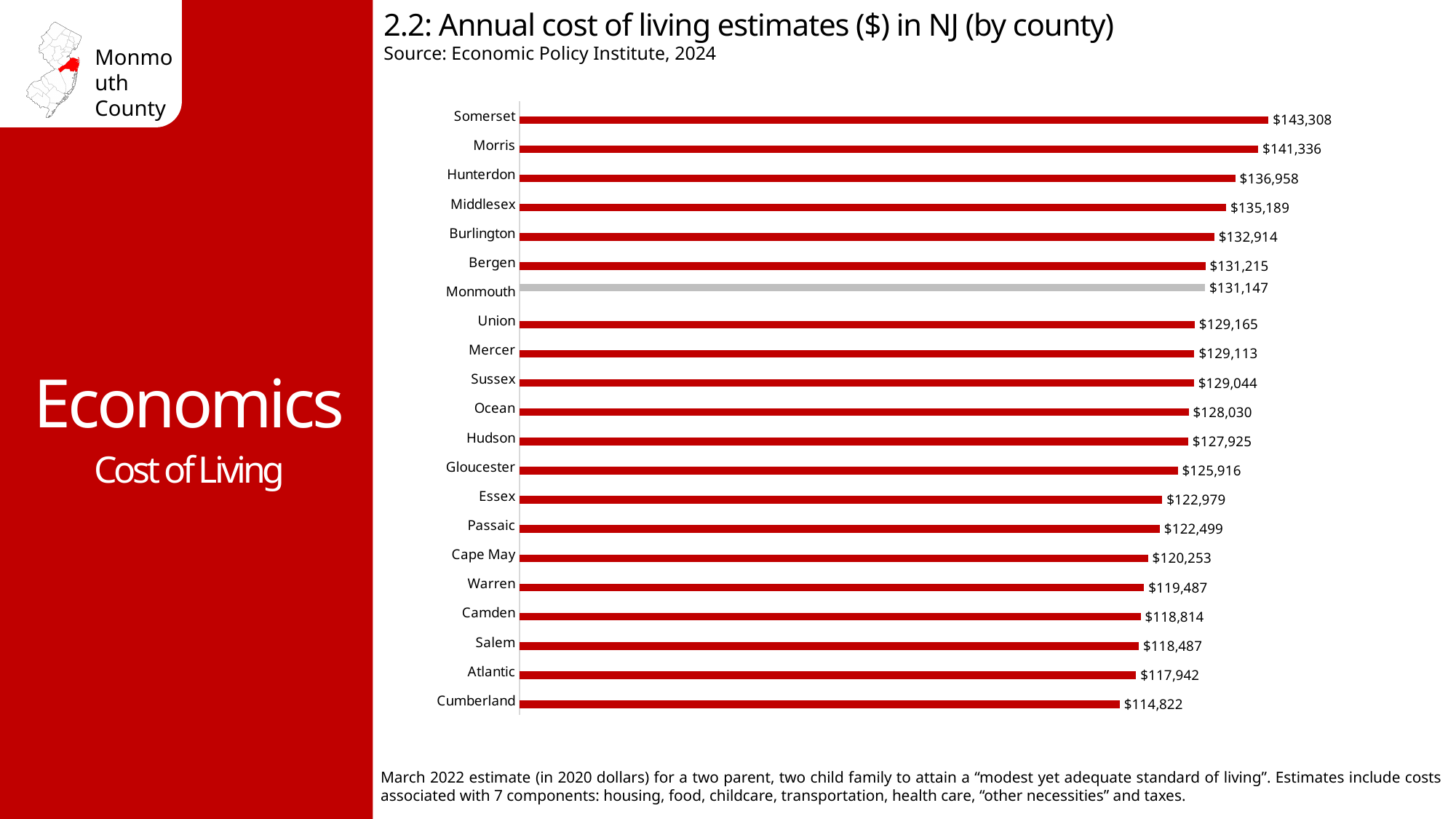
How many counties are shown in the chart? 21 Which county has the highest annual cost of living estimate? Somerset What type of chart is shown on the slide? bar chart What is the source cited for the chart? Economic Policy Institute, 2024 What is the difference between the cost of living estimates for Somerset and Cumberland counties? $28,486 Which county has a higher cost of living estimate, Gloucester or Essex? Gloucester Which county has the lowest annual cost of living estimate? Cumberland What is the annual cost of living estimate for Cape May County? $120,253 What is the difference between the cost of living estimates for Bergen and Monmouth counties? $68 What is the annual cost of living estimate for Monmouth County? $131,147 Which county's bar is shown in grey instead of red? Monmouth What is the annual cost of living estimate for Hunterdon County? $136,958